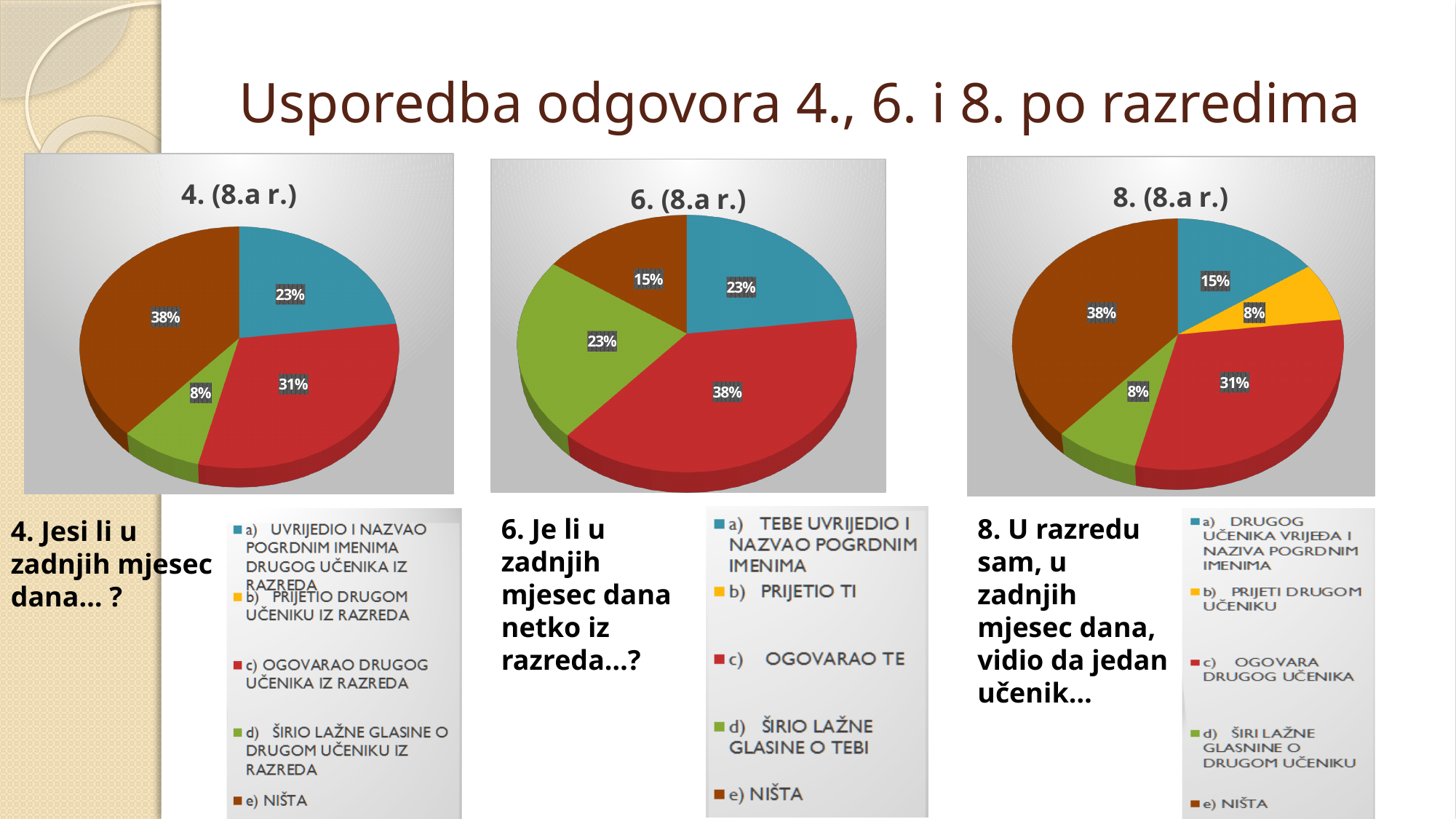
In the chart titled "8. (8.a r.)", what percentage is shown for the yellow slice (b) PRIJETI DRUGOM UČENIKU)? 8% In the chart titled "8. (8.a r.)", how many slices are shown in the pie? 5 In the chart titled "8. (8.a r.)", what is the difference between the brown slice (38%) and the red slice (31%)? 7% In the chart titled "4. (8.a r.)", which slice has the smallest share? d) ŠIRIO LAŽNE GLASINE O DRUGOM UČENIKU IZ RAZREDA (green, 8%) In the chart titled "6. (8.a r.)", what percentage is shown for the red slice (c) OGOVARAO TE)? 38% In the chart titled "6. (8.a r.)", what percentage is shown for the brown slice (e) NIŠTA)? 15% In the chart titled "4. (8.a r.)", what percentage is shown for the brown slice (e) NIŠTA)? 38% In the chart titled "6. (8.a r.)", which slice is the largest? c) OGOVARAO TE (red, 38%) In the chart titled "6. (8.a r.)", which is larger: the blue slice or the brown slice? the blue slice (23%) What type of chart is used for "4. (8.a r.)"? pie chart In the chart titled "8. (8.a r.)", what percentage is shown for the blue slice (a) DRUGOG UČENIKA VRIJEĐA I NAZIVA POGRDNIM IMENIMA)? 15% In the chart titled "4. (8.a r.)", what percentage is shown for the red slice (c) OGOVARAO DRUGOG UČENIKA IZ RAZREDA)? 31%